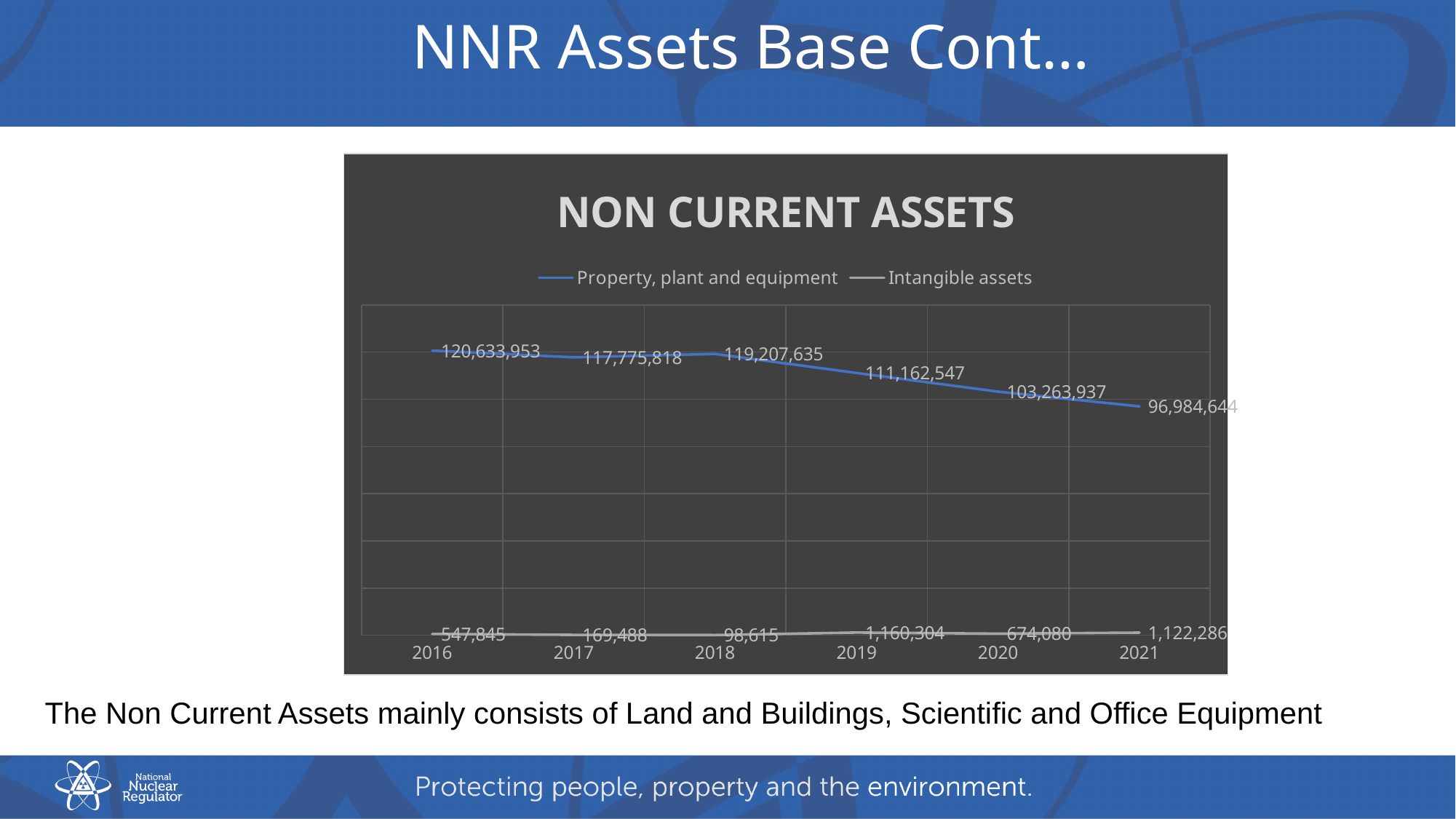
What is the difference between Property, plant and equipment in 2016 and in 2021? 23,649,309 What is the value of Intangible assets in 2019? 1,160,304 What is the value of Property, plant and equipment in 2021? 96,984,644 What is the title of the chart? NON CURRENT ASSETS In which year is Property, plant and equipment at its highest? 2016 What is the value of Property, plant and equipment in 2016? 120,633,953 How many years are plotted on the x axis? 6 How many series does the legend list? 2 Does Property, plant and equipment generally rise or fall from 2016 to 2021? Fall What type of chart is shown on the slide? Line chart In which year is Property, plant and equipment at its lowest? 2021 In which year is Intangible assets at its lowest? 2018